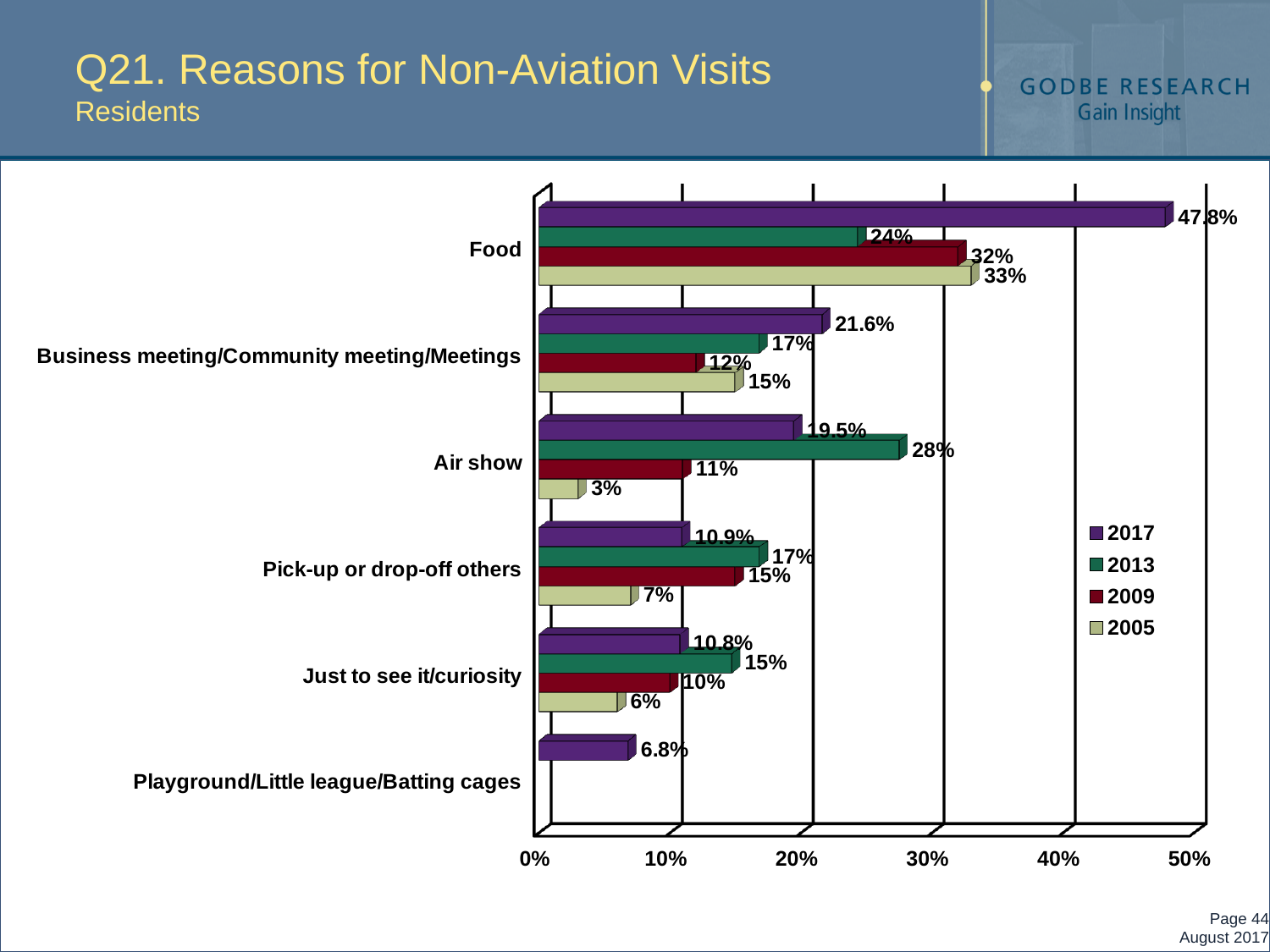
How many series does the legend list? 4 For Air show, which is larger: the 2013 value or the 2017 value? 2013 What is the 2017 value for Playground/Little league/Batting cages? 6.8% Which category has the lowest 2005 value? Air show What kind of chart is shown on the slide? Bar chart Which category has the highest 2017 value? Food Which year does the purple series represent? 2017 What is the difference between the 2017 and 2013 values for Food? 23.8% What is the 2013 value for Air show? 28% What is the 2005 value for Pick-up or drop-off others? 7% What is the 2017 value for Food? 47.8% How many categories are shown on the chart? 6